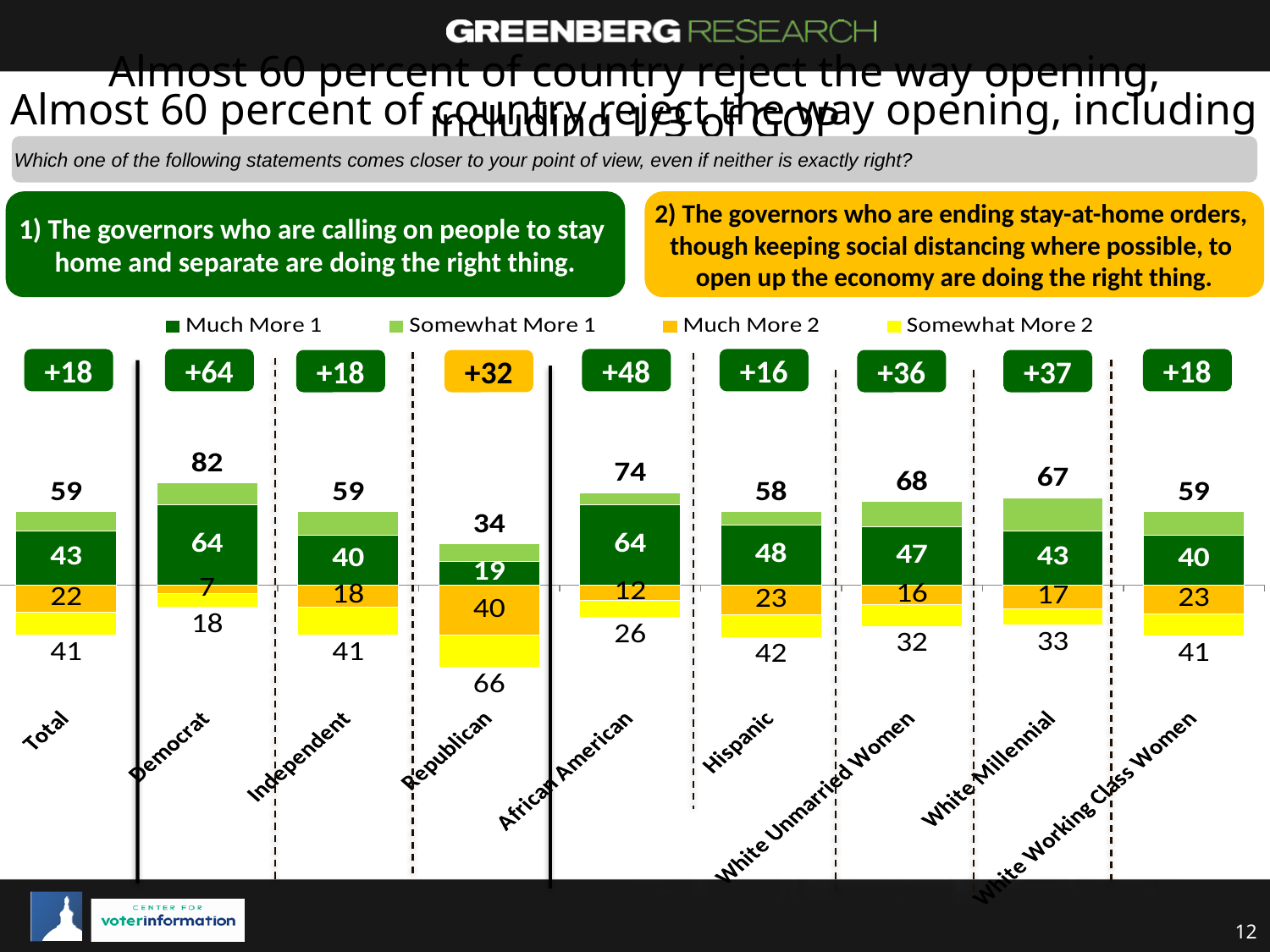
How many groups (categories) are shown along the x axis of the chart? 9 How many series does the legend list? 4 What is the total for statement 1 (the number printed above the bar) for Hispanic? 58 What kind of chart is shown on the slide? bar chart What is the 'Much More 2' value for Republican? 40 What is the net figure shown in the box above the Republican bar? +32 What is the second entry listed in the chart legend? Somewhat More 1 What is the 'Much More 1' value for Democrat? 64 Which is larger, the 'Much More 1' value for African American or for White Millennial? African American Which group has the lowest total for statement 1 (the number printed above the bar)? Republican What is the difference between the statement 1 totals for Democrat (82) and Republican (34)? 48 Which group has the highest total for statement 1 (the number printed above the bar)? Democrat